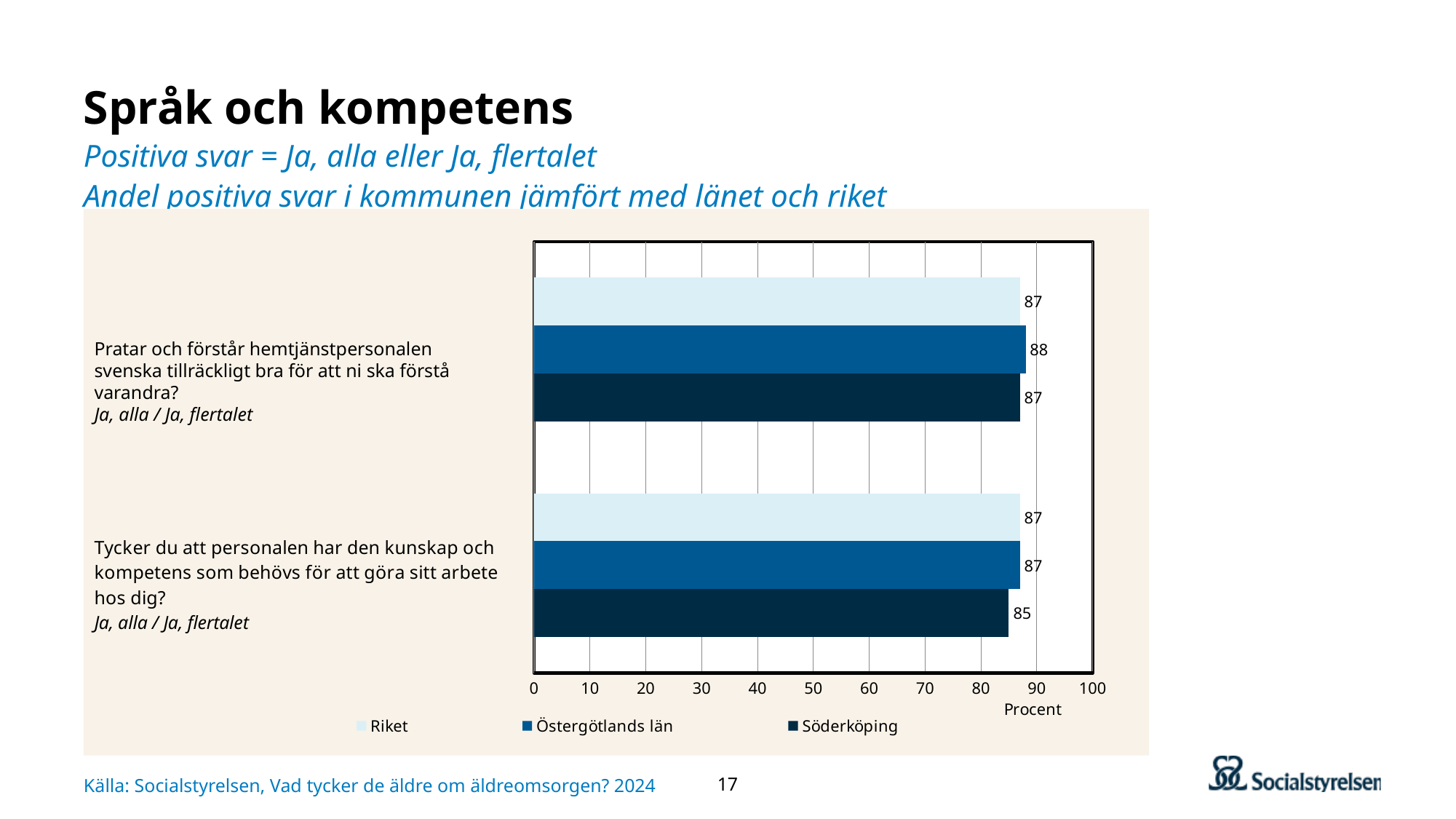
What is the label of the x axis? Procent What is the value for Söderköping on the question "Pratar och förstår hemtjänstpersonalen svenska tillräckligt bra för att ni ska förstå varandra?"? 87 How many questions (categories) are plotted in the chart? 2 Which series has the lowest value on the question "Tycker du att personalen har den kunskap och kompetens som behövs för att göra sitt arbete hos dig?"? Söderköping What is the value for Riket on the question "Tycker du att personalen har den kunskap och kompetens som behövs för att göra sitt arbete hos dig?"? 87 How many series does the legend list? 3 Is the value for Söderköping on the question "Tycker du att personalen har den kunskap och kompetens som behövs för att göra sitt arbete hos dig?" greater or less than 90? less What is the difference between Riket and Söderköping on the question "Tycker du att personalen har den kunskap och kompetens som behövs för att göra sitt arbete hos dig?"? 2 Which series has the highest value on the question "Pratar och förstår hemtjänstpersonalen svenska tillräckligt bra för att ni ska förstå varandra?"? Östergötlands län What is the value for Östergötlands län on the question "Pratar och förstår hemtjänstpersonalen svenska tillräckligt bra för att ni ska förstå varandra?"? 88 What kind of chart is shown on the slide? bar chart What is the value for Söderköping on the question "Tycker du att personalen har den kunskap och kompetens som behövs för att göra sitt arbete hos dig?"? 85